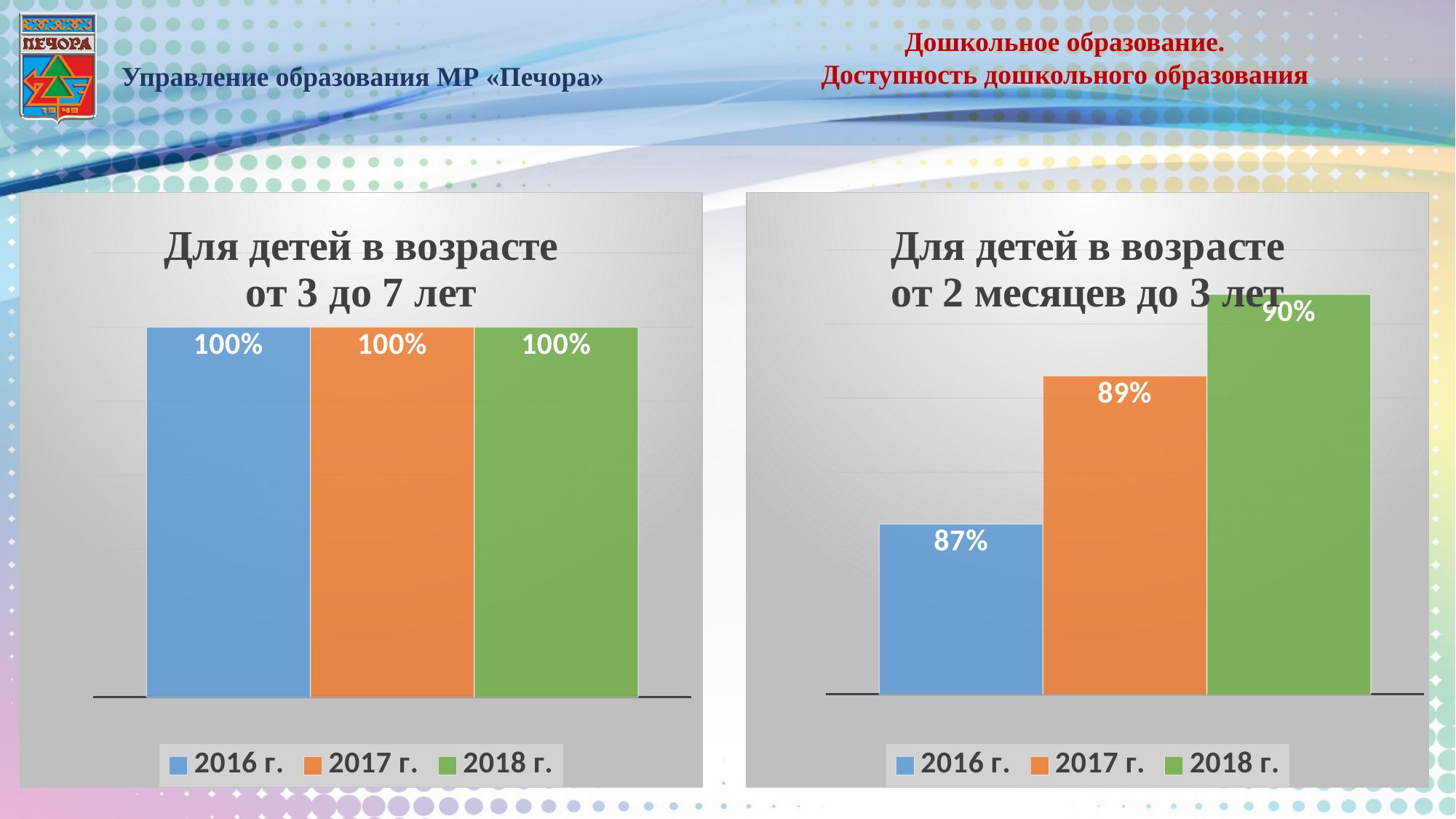
In the chart 'Для детей в возрасте от 2 месяцев до 3 лет', what is the value for 2016 г.? 87% What kind of chart is the chart 'Для детей в возрасте от 2 месяцев до 3 лет'? bar chart In the chart 'Для детей в возрасте от 2 месяцев до 3 лет', which year has the lowest value? 2016 г. How many series does the legend of the chart 'Для детей в возрасте от 3 до 7 лет' list? 3 In the chart 'Для детей в возрасте от 2 месяцев до 3 лет', do the values rise or fall from 2016 г. to 2018 г.? rise In the chart 'Для детей в возрасте от 2 месяцев до 3 лет', what is the value for 2017 г.? 89% In the chart 'Для детей в возрасте от 2 месяцев до 3 лет', what is the value for 2018 г.? 90% In the chart 'Для детей в возрасте от 2 месяцев до 3 лет', which is larger: the value for 2017 г. or the value for 2016 г.? 2017 г. In the chart 'Для детей в возрасте от 2 месяцев до 3 лет', which year has the highest value? 2018 г. In the chart 'Для детей в возрасте от 2 месяцев до 3 лет', what is the difference between the values for 2018 г. and 2016 г.? 3% In the chart 'Для детей в возрасте от 3 до 7 лет', what is the value for 2016 г.? 100% In the chart 'Для детей в возрасте от 3 до 7 лет', what is the value for 2018 г.? 100%